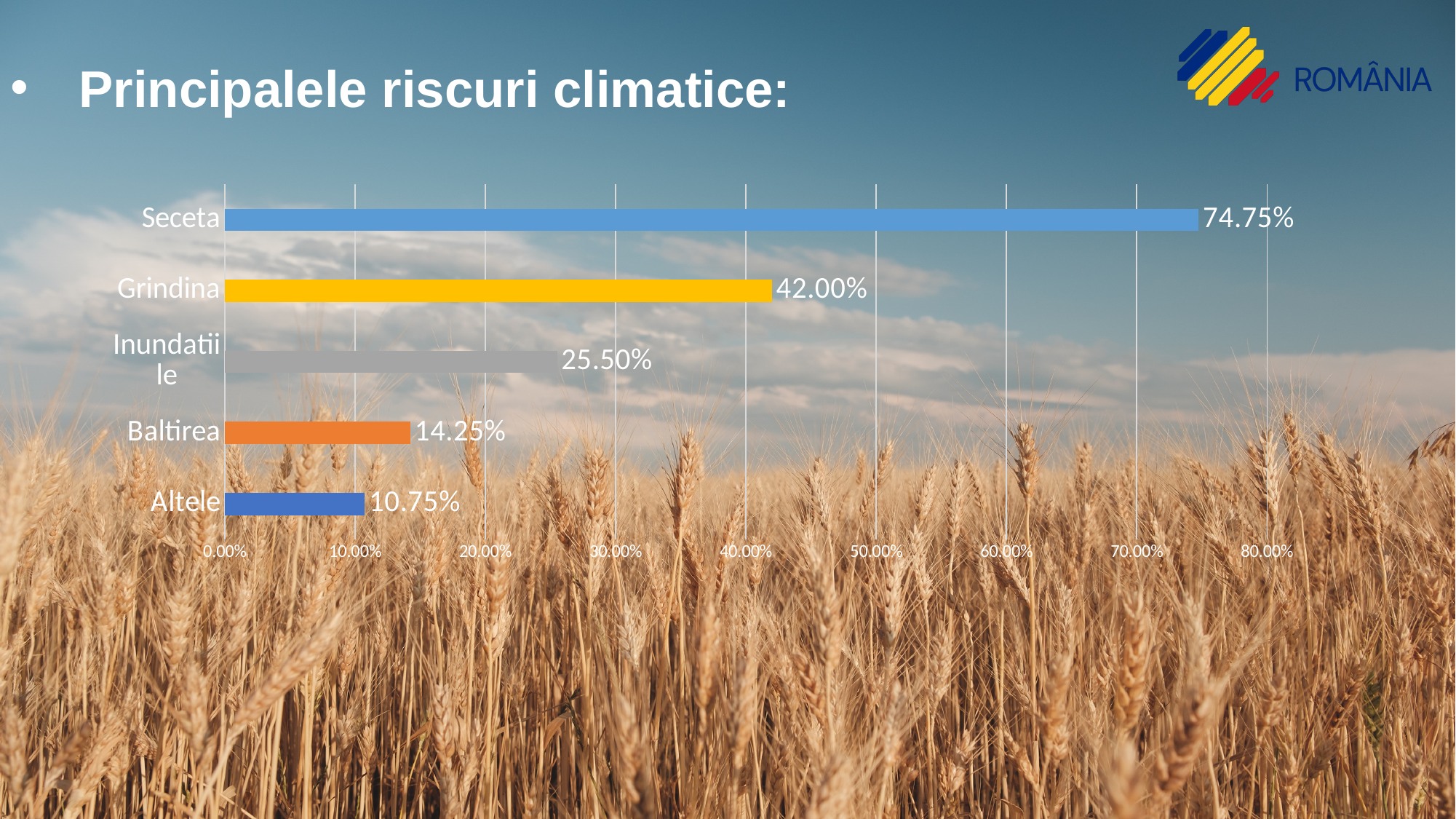
What is the difference between the values for Seceta and Grindina? 32.75% What is the value for Grindina? 42.00% Is the value for Grindina greater or less than 40.00%? greater Which is larger, the value for Inundatiile or the value for Baltirea? Inundatiile What is the value for Inundatiile? 25.50% Which category has the lowest value? Altele What is the value for Altele? 10.75% What kind of chart is shown on the slide? bar chart What is the value for Seceta? 74.75% Which category has the highest value? Seceta What is the value for Baltirea? 14.25% How many categories are shown in the chart? 5